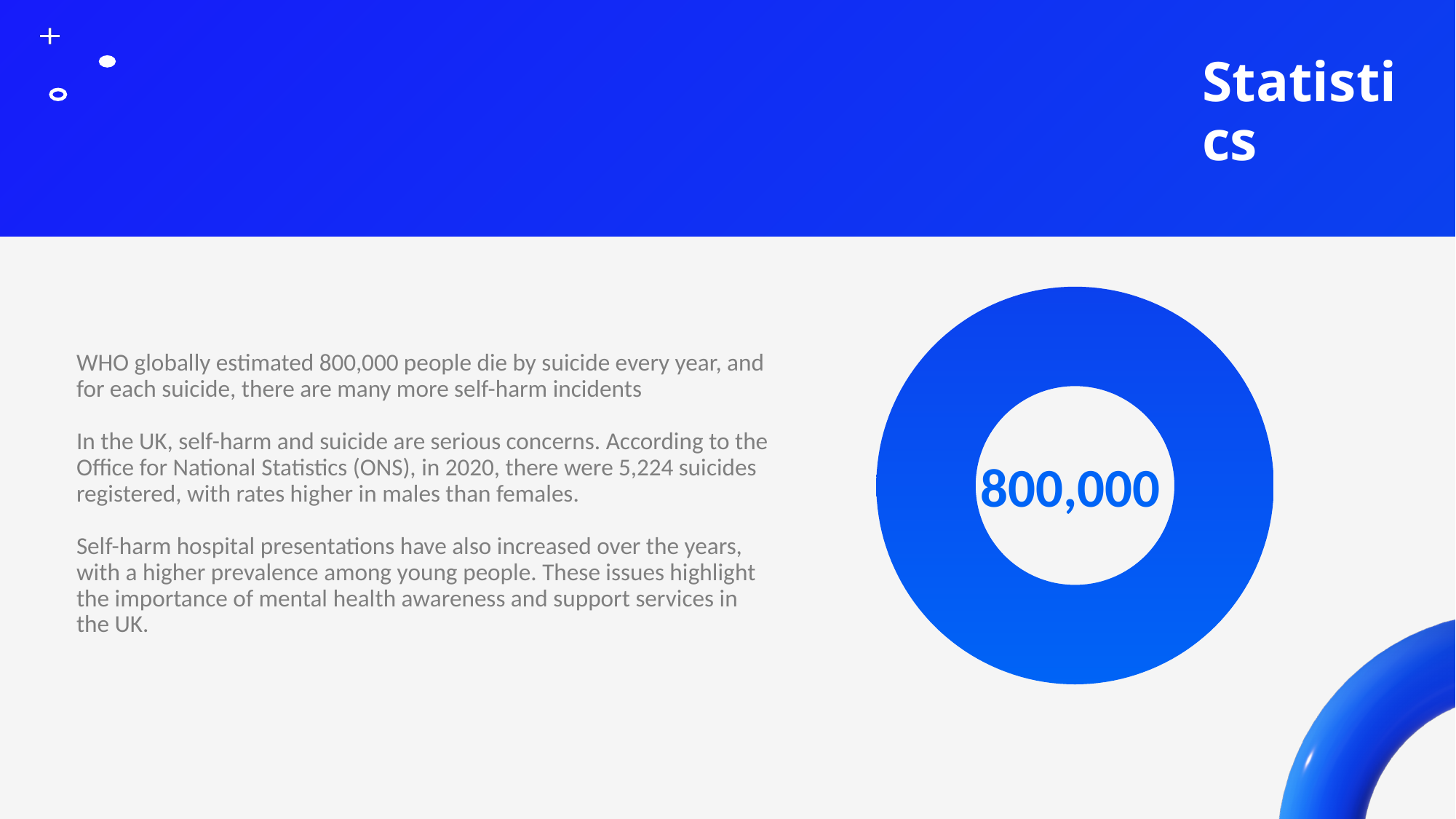
How many distinct slices does the doughnut chart show? 1 Does the doughnut chart have a legend? No What colour is the ring of the doughnut chart? blue What kind of chart is shown on the right side of the slide? doughnut chart What number is printed in the centre of the doughnut chart? 800,000